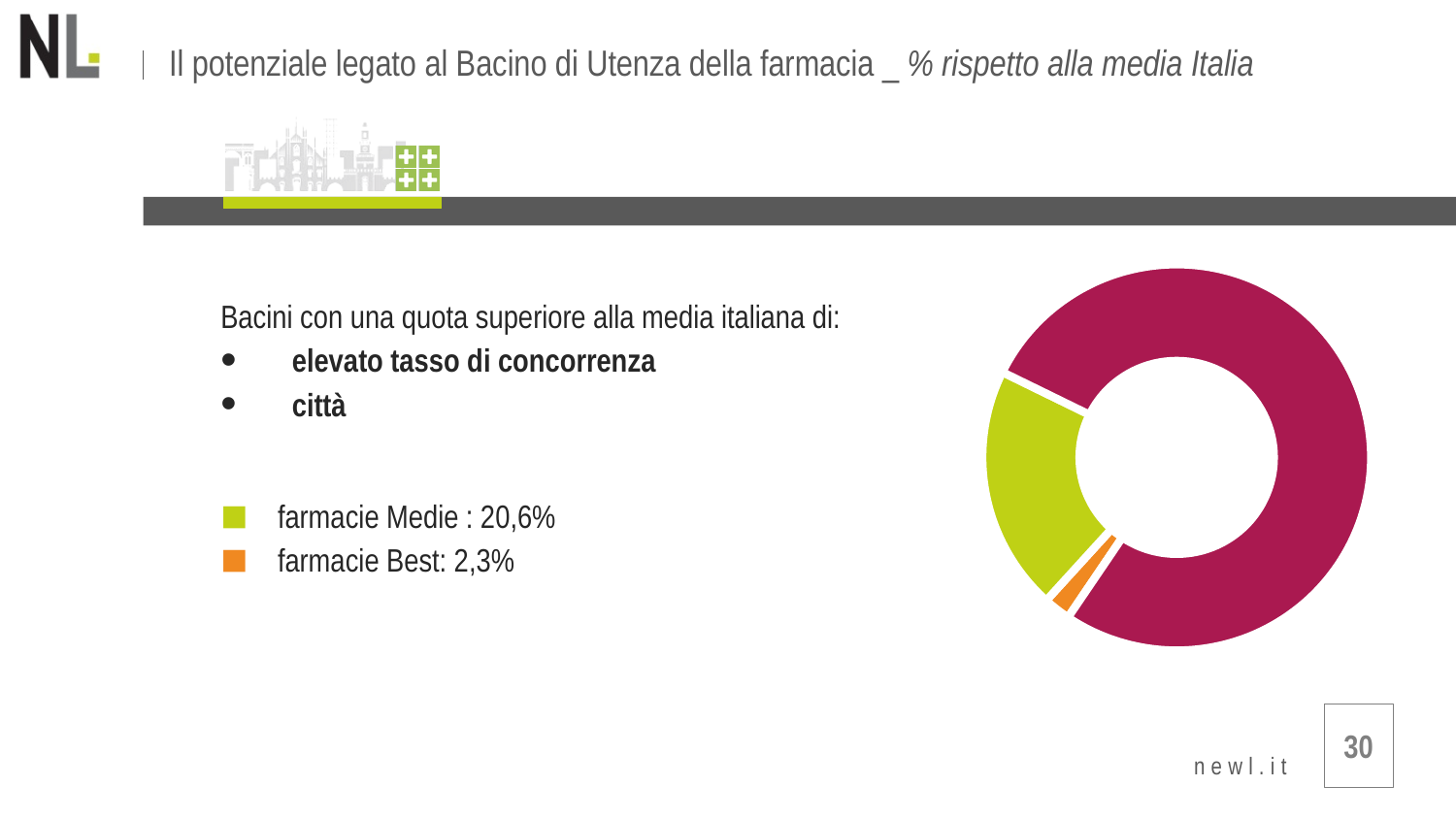
What colour is the slice for farmacie Best? Orange Of the two labelled categories, which has the higher value? farmacie Medie Which is larger, the value for farmacie Medie or for farmacie Best? farmacie Medie What is the difference between the values for farmacie Medie and farmacie Best? 18,3% How many slices does the donut chart have? 3 What is the value shown for farmacie Best? 2,3% How many entries does the legend list? 2 What kind of chart is shown on the slide? Pie chart (donut) What colour is the largest slice of the donut chart? Magenta Of the two labelled categories, which has the lower value? farmacie Best What is the value shown for farmacie Medie? 20,6%